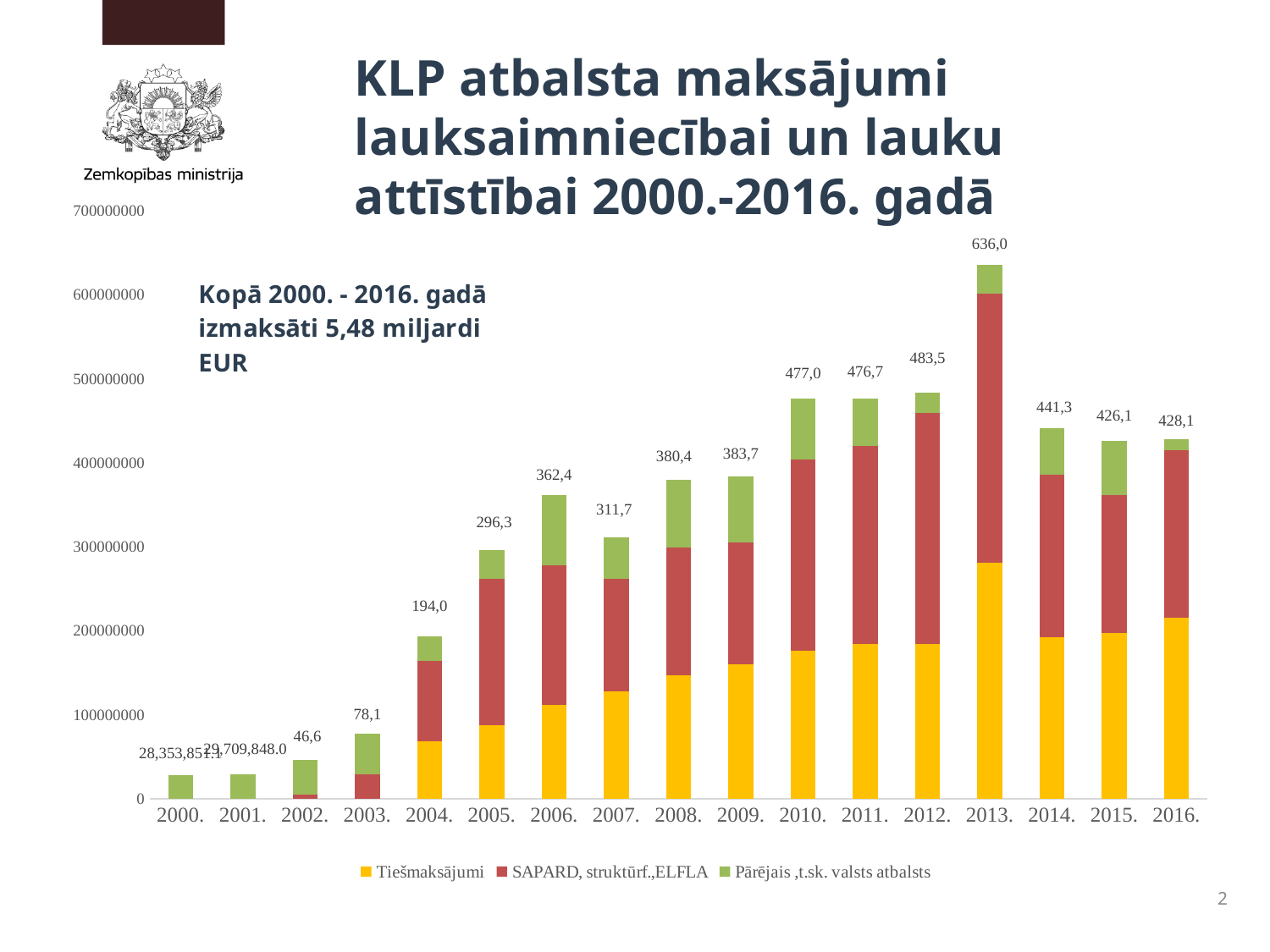
What is the difference between the labelled totals for 2013 and 2012? 152,5 Which year has the highest total bar? 2013. Is the Tiešmaksājumi value for 2013 greater or less than 200000000? greater What is the total value labelled for 2016? 428,1 What is the total value labelled for 2013? 636,0 How many series does the legend list? 3 What is the total value labelled for 2005? 296,3 Do the labelled totals rise or fall from 2004 to 2006? rise What kind of chart is shown on the slide? Stacked bar chart How many years are shown on the x axis? 17 Which year has the larger labelled total, 2007 or 2008? 2008. What is the difference between the labelled totals for 2010 and 2009? 93,3